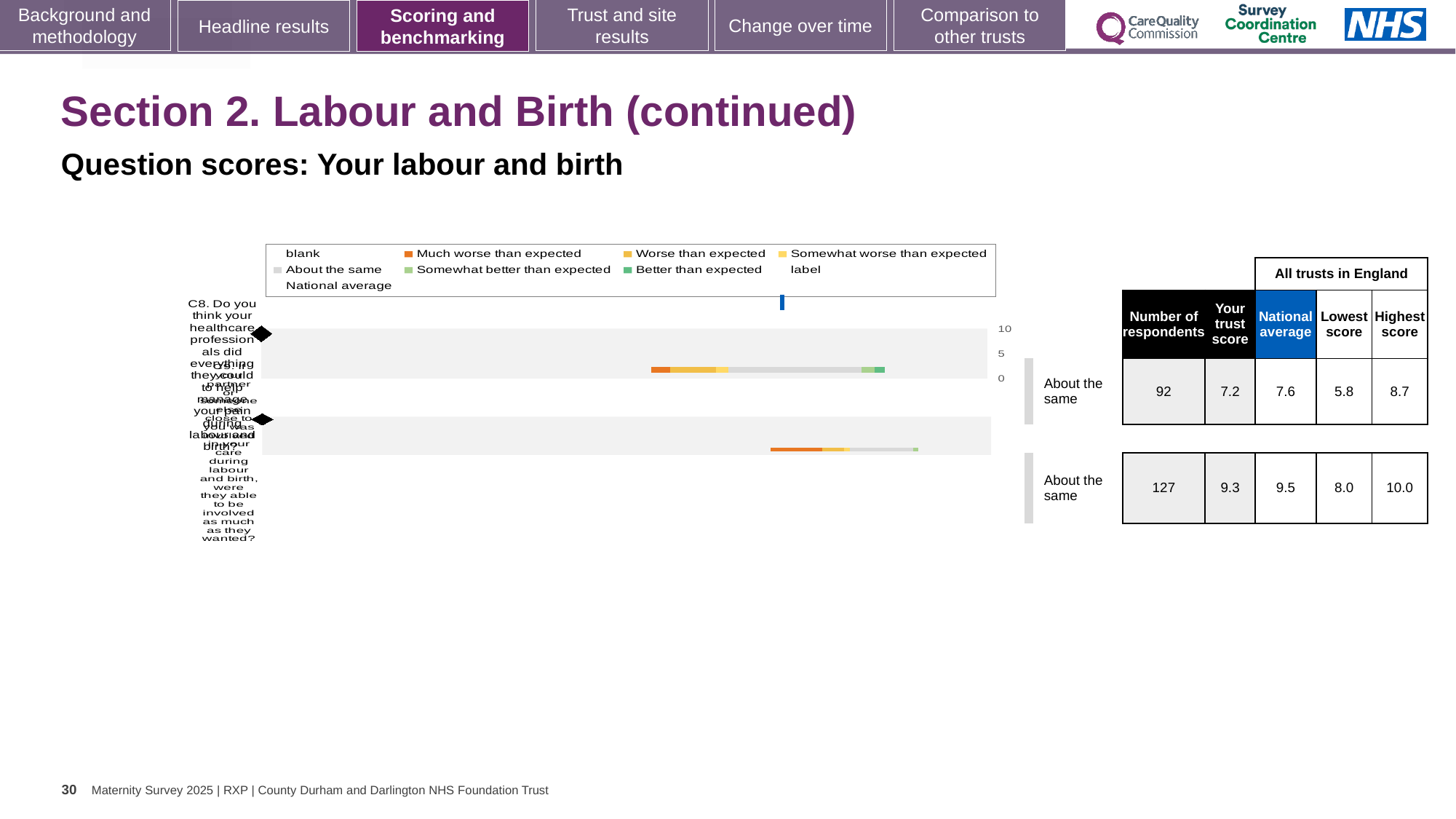
In the table beside the chart, what is the number of respondents for the second row? 127 What kind of chart is shown on the slide? bar chart For question C8 (the first row), what is the difference between the highest score and the lowest score? 2.9 What benchmark category is shown for question C8 (the first row)? About the same In the table beside the chart, what is the trust score for question C8 (the first row)? 7.2 In the table beside the chart, what is the number of respondents for question C8 (the first row)? 92 In the table beside the chart, what is the highest score for the second row? 10.0 In the chart legend, what colour represents 'Much worse than expected'? orange For question C8 (the first row), which is larger: the trust score or the national average? national average How many survey questions (rows) are plotted in the chart? 2 In the table beside the chart, what is the national average for question C8 (the first row)? 7.6 In the chart legend, what colour represents 'Better than expected'? green